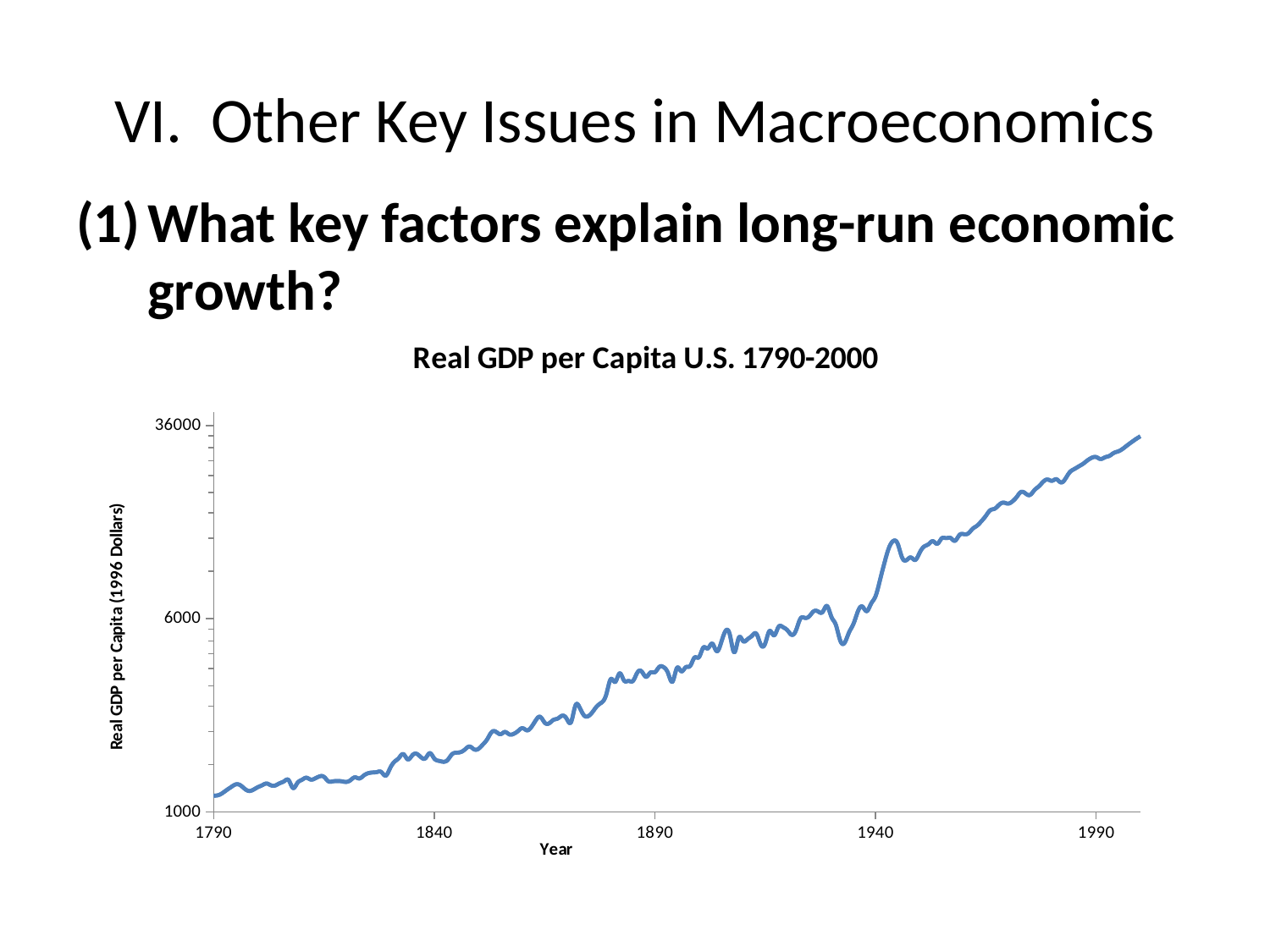
What is the label of the y axis of the chart? Real GDP per Capita (1996 Dollars) Is the value for 1790 greater or less than 6000? less Which year has the larger value, 1840 or 1890? 1890 Which year has the larger value, 1790 or 1990? 1990 What is the title of the chart? Real GDP per Capita U.S. 1790-2000 What kind of chart is shown on the slide? line chart Is the value for 1890 greater or less than 6000? less Is the value for 1840 greater or less than 6000? less How many lines are plotted on the chart? 1 Does real GDP per capita generally rise or fall from 1790 to 2000 along the x axis? rise